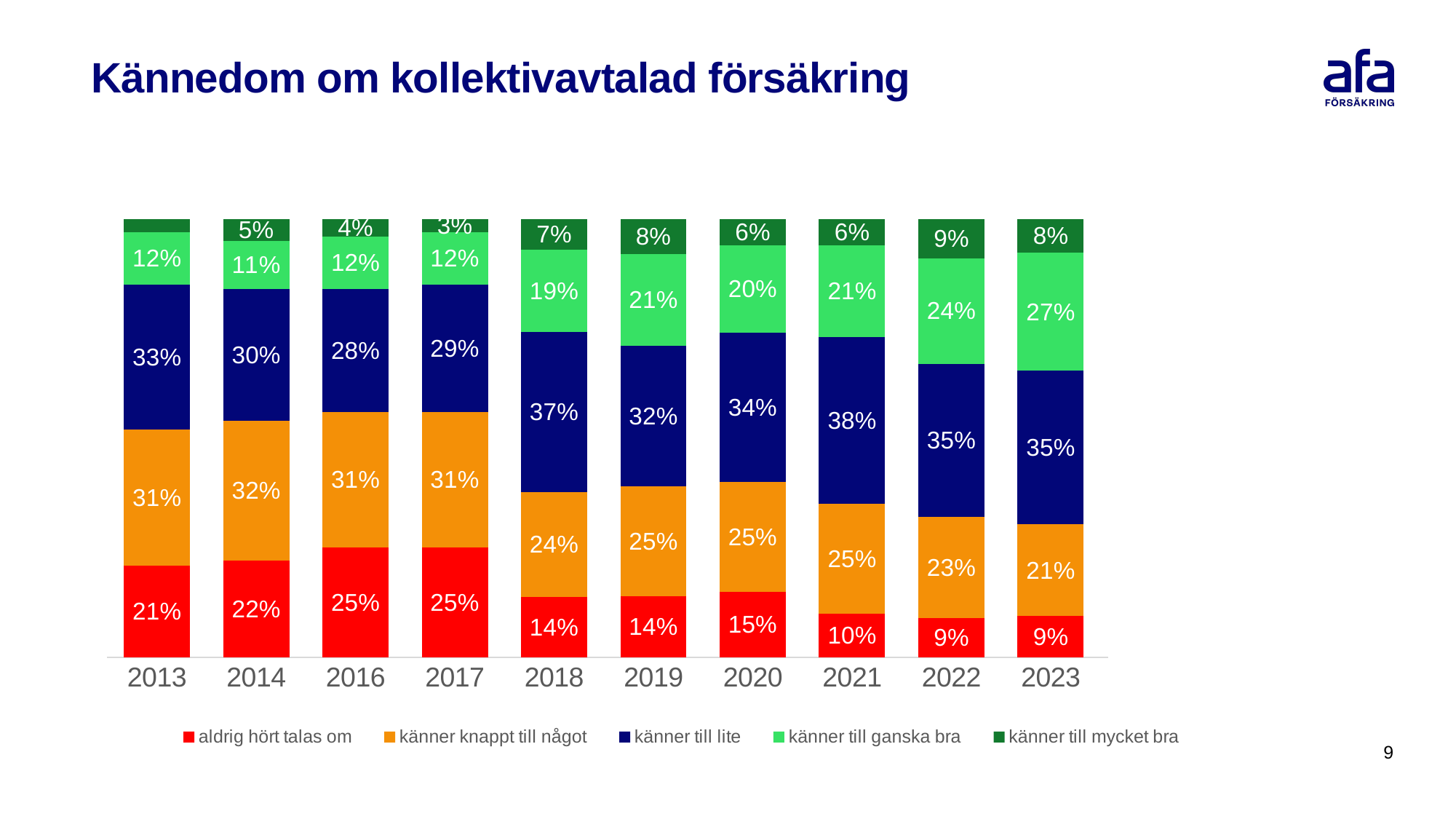
What is the value for 'känner till lite' in 2021? 38% Which is larger: 'känner knappt till något' in 2014 or in 2023? 2014 What is the value for 'känner till mycket bra' in 2022? 9% How many years are shown on the x axis? 10 What is the difference between the 'känner till ganska bra' value in 2023 and in 2013? 15% How many series does the legend list? 5 What kind of chart is shown on the slide? stacked bar chart In which year is the 'känner till mycket bra' share lowest among the labelled values? 2017 What is the value for 'känner till ganska bra' in 2023? 27% Does the 'aldrig hört talas om' share rise or fall from 2017 to 2023? fall What is the value for 'aldrig hört talas om' in 2013? 21% In which year is the 'aldrig hört talas om' share highest? 2016 and 2017